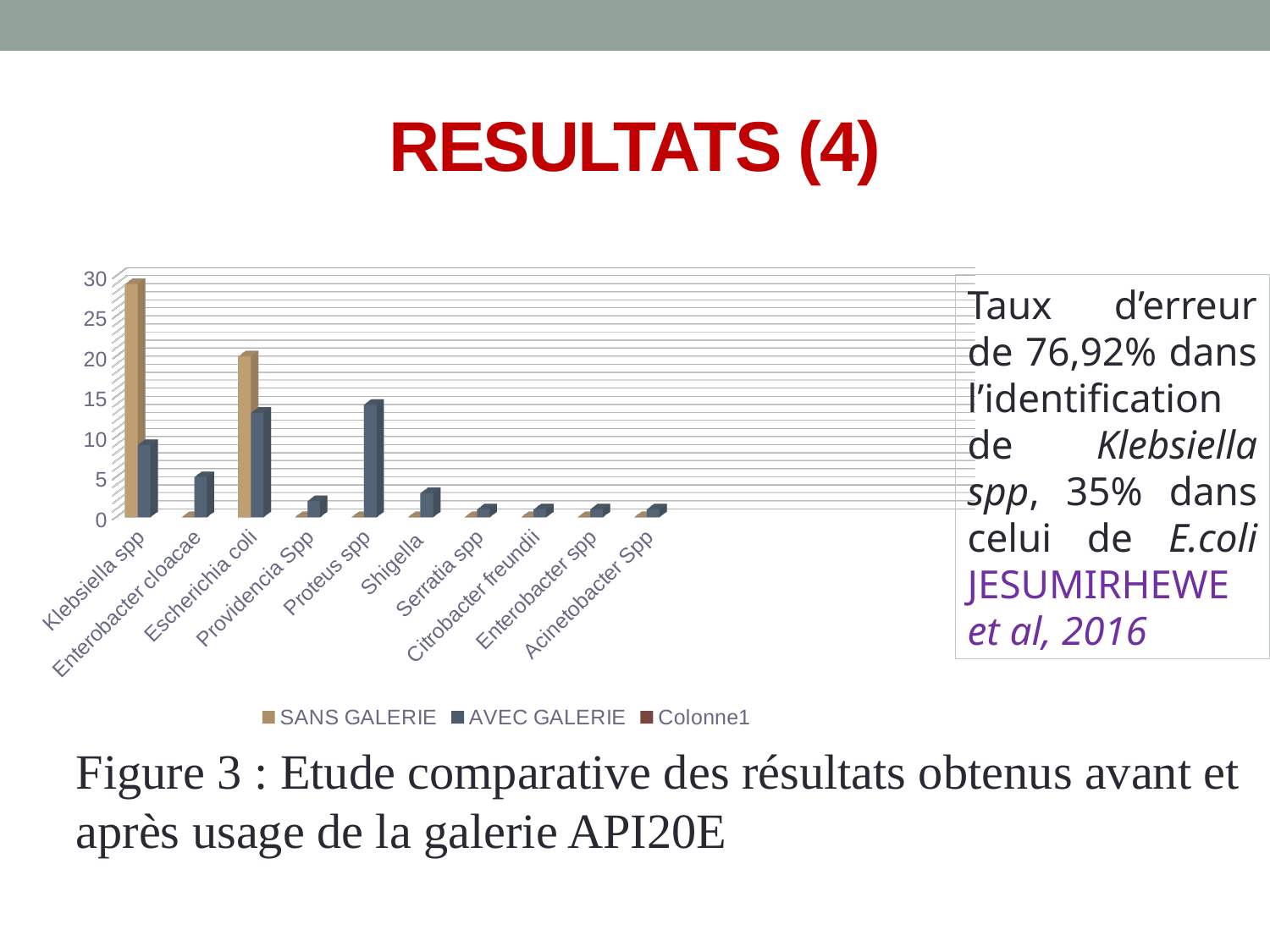
What is the figure number given in the caption below the chart? Figure 3 Is the AVEC GALERIE value for Klebsiella spp greater or less than 15? less How many bacterial categories are shown on the x axis of the chart? 10 How many series does the chart legend list? 3 Which has the larger SANS GALERIE value, Klebsiella spp or Escherichia coli? Klebsiella spp What are the three entries in the chart legend? SANS GALERIE, AVEC GALERIE, Colonne1 Which category has the highest SANS GALERIE value? Klebsiella spp Is the SANS GALERIE value for Klebsiella spp greater or less than 25? greater For Klebsiella spp, which series has the larger value, SANS GALERIE or AVEC GALERIE? SANS GALERIE Is the SANS GALERIE value for Escherichia coli greater or less than 15? greater What kind of chart is shown on the slide? Bar chart